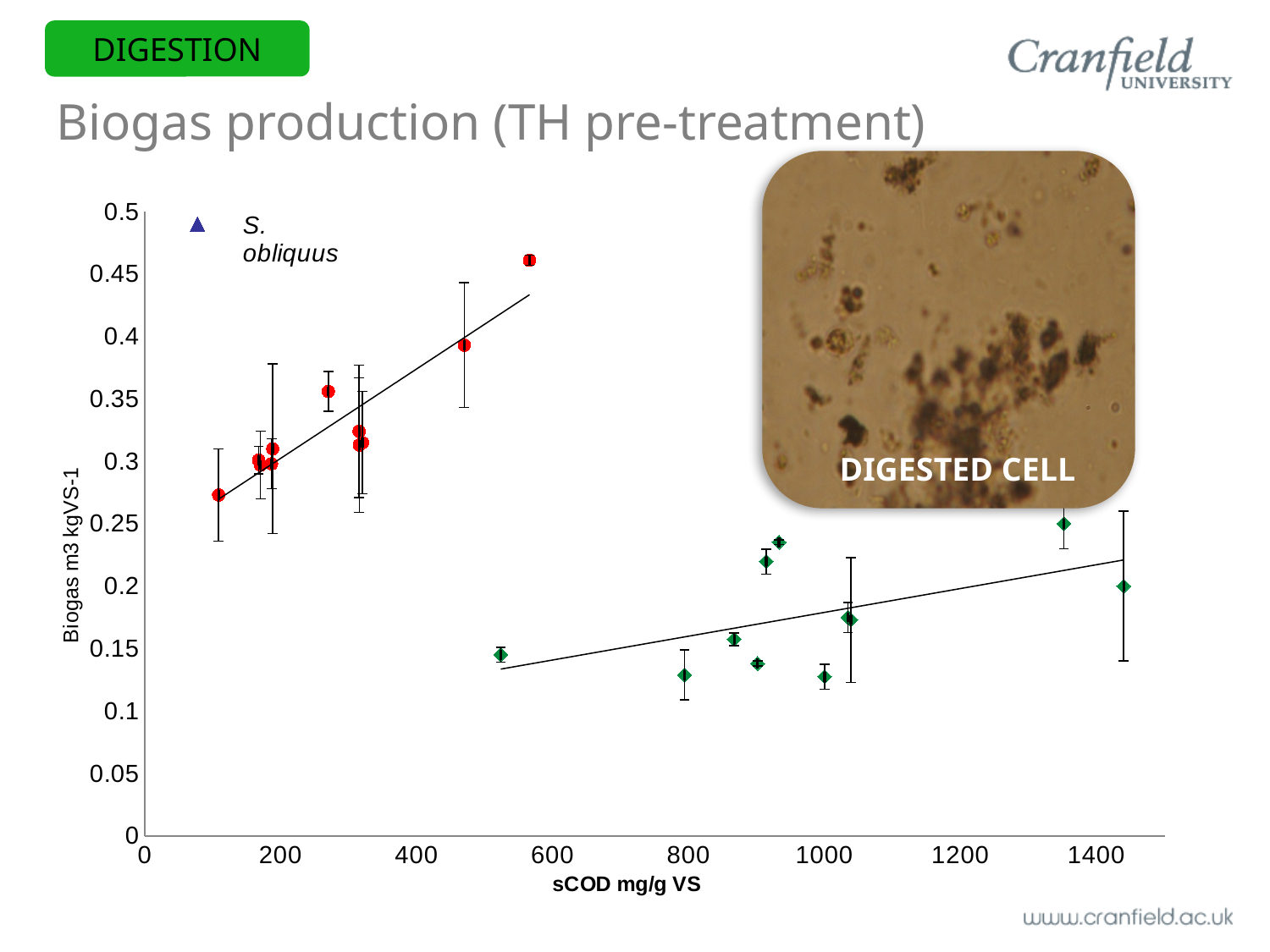
Is the biogas value for the green point at about 800 sCOD mg/g VS greater or less than 0.15? less Is the biogas value for the green point at about 1350 sCOD mg/g VS greater or less than 0.2? greater Is the biogas value for the red point at about 110 sCOD mg/g VS greater or less than 0.3? less What kind of chart is shown on the slide? scatter chart Do the biogas values of the red circle points rise or fall as sCOD increases? rise What is the highest value shown on the y axis of the chart? 0.5 Which series has the higher biogas values overall, the red circles or the green diamonds? red circles Which point has the highest biogas value on the chart: the red point at about 570 sCOD or the green point at about 1350 sCOD? the red point at about 570 sCOD What is the label of the x axis of the chart? sCOD mg/g VS What is the label of the y axis of the chart? Biogas m3 kgVS-1